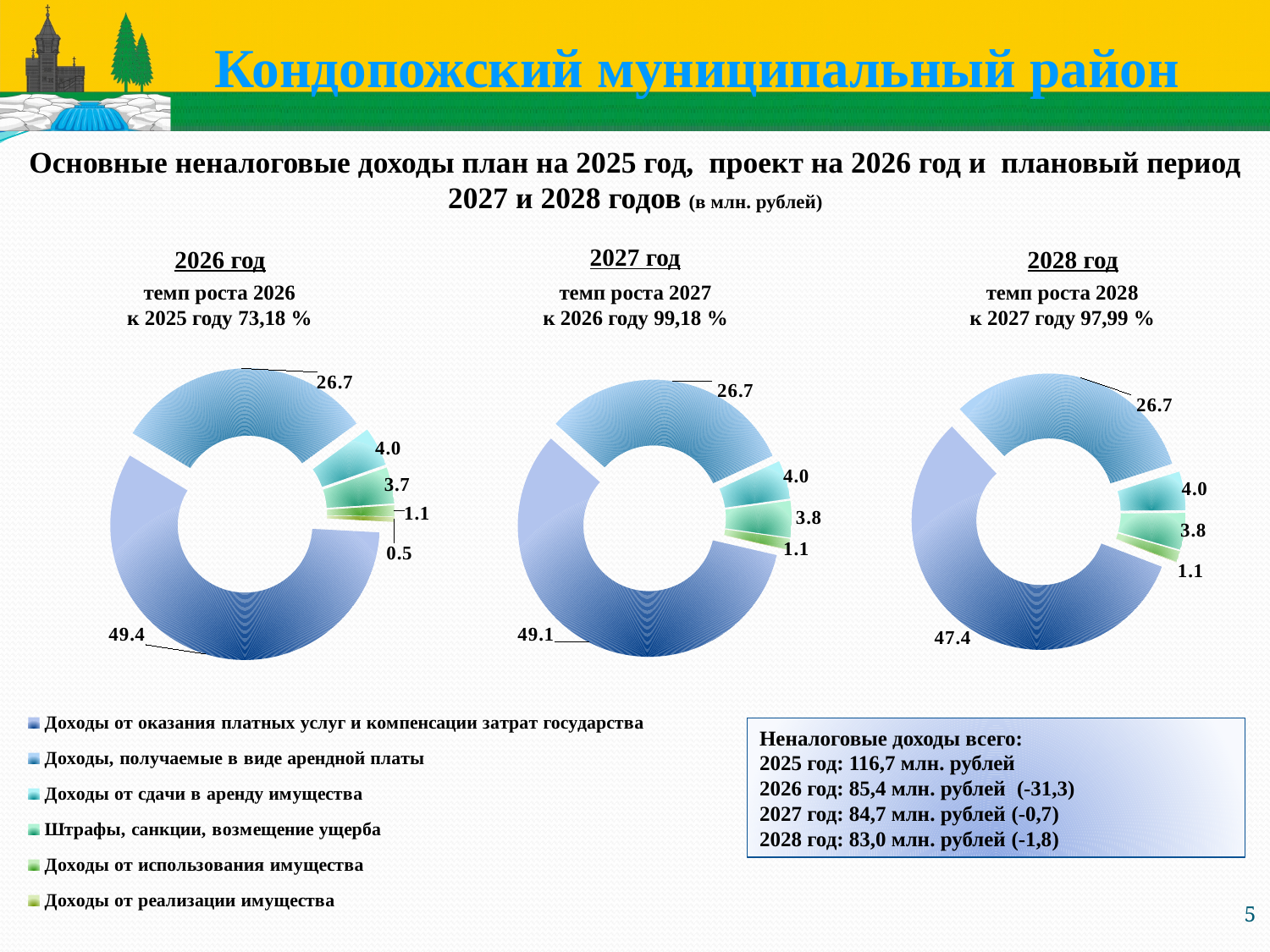
In the 2026 год chart, what is the value of the smallest slice? 0.5 What is the total of all slices in the 2026 год chart? 85.4 How many slices does the 2027 год chart have? 5 What growth rate (темп роста) is shown above the 2026 год chart? 73,18 % Which chart has the larger biggest slice, 2027 год (49.1) or 2028 год (47.4)? 2027 год In the 2028 год chart, what is the value of the largest slice? 47.4 In the 2027 год chart, what is the difference between the largest slice (49.1) and the second largest slice (26.7)? 22.4 How many slices does the 2026 год chart have? 6 In the 2026 год chart, what is the value of the largest slice? 49.4 In the 2027 год chart, what is the value of the smallest slice? 1.1 What kind of chart is used to show the 2026 data? Doughnut (pie) chart How many entries does the legend list? 6